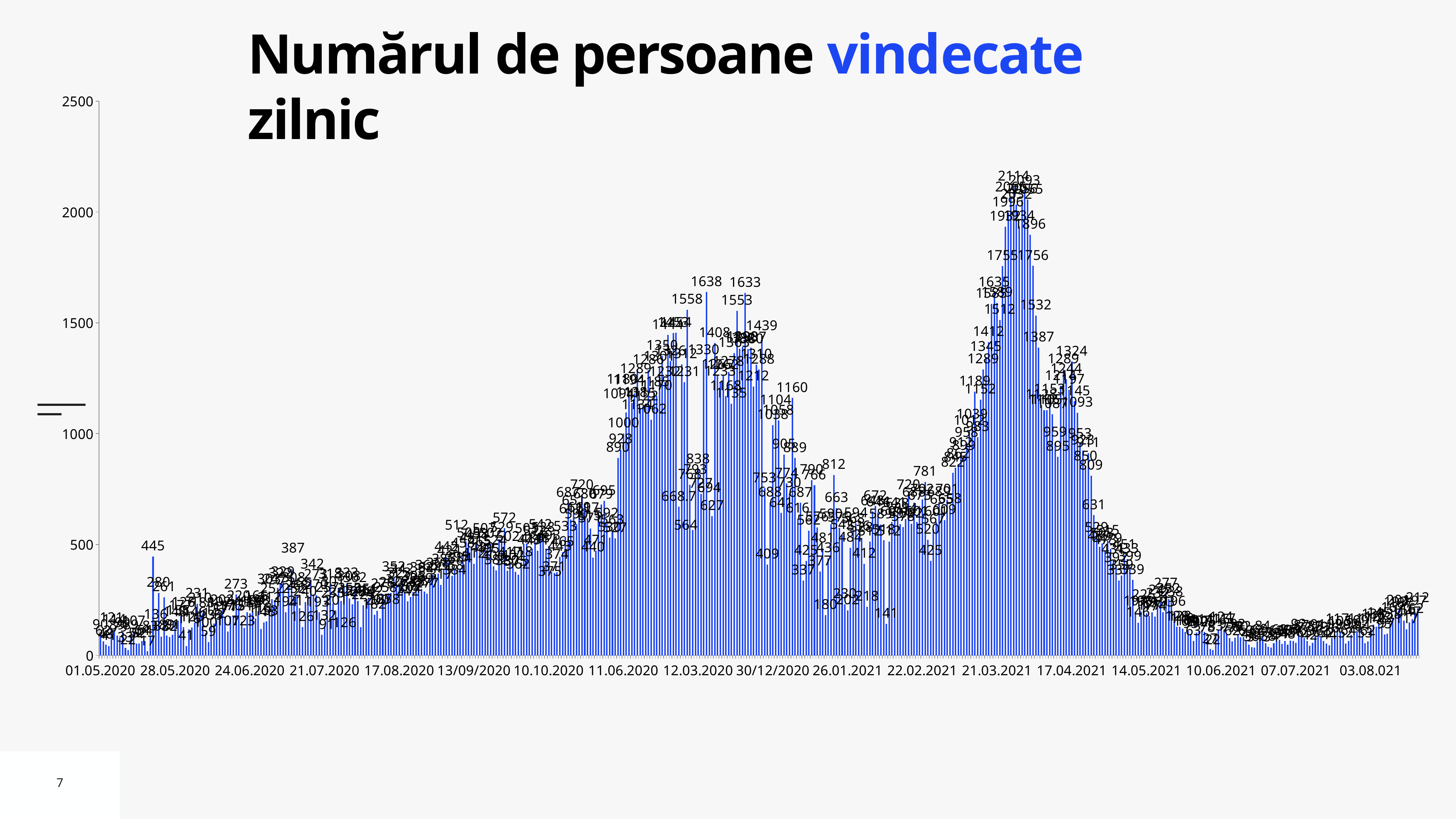
Do the values rise or fall between the 17.04.2021 label and the 10.06.2021 label? fall What kind of chart is shown on the slide? bar chart Which is larger: the peak labelled 2114 near 21.03.2021 or the peak labelled 1638 near 12.03.2020? 2114 What is the highest data label printed on the chart? 2114 What is the highest value shown on the vertical axis? 2500 What is the difference between the peak labelled 2114 and the peak labelled 1638? 476 Is the tallest bar in the first small peak, labelled 445 near 28.05.2020, greater or less than 500? less Are the bars near the 07.07.2021 label greater or less than 500? less How many date labels are printed along the horizontal axis? 18 Is the tallest bar, near the 21.03.2021 label, greater or less than 2000? greater Do the values rise or fall between the 22.02.2021 label and the 21.03.2021 label? rise What is the title of the chart? Numărul de persoane vindecate zilnic